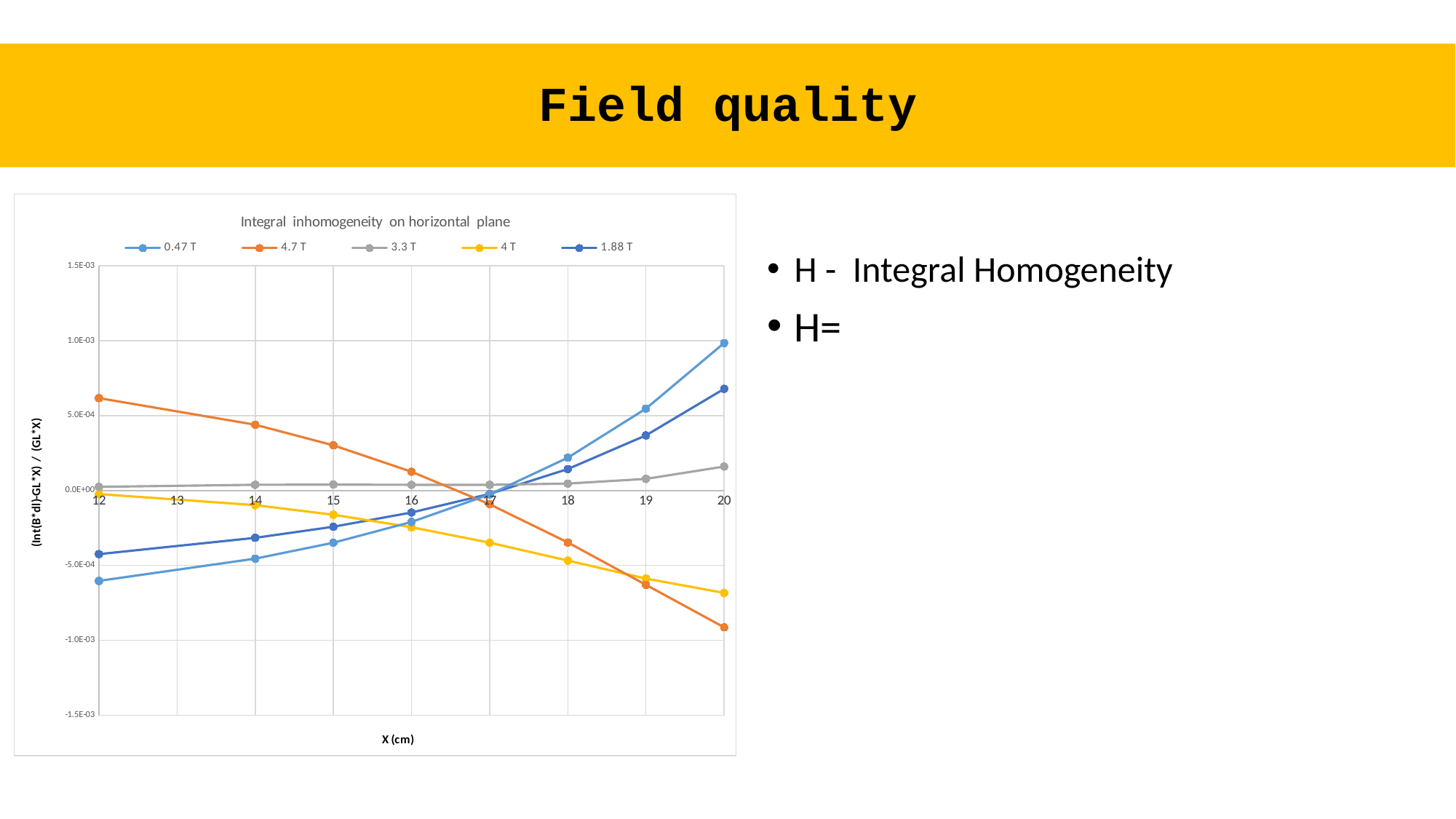
What kind of chart is shown on the slide? line chart At X = 20, which is larger: the 0.47 T series or the 1.88 T series? 0.47 T Is the value of the 4.7 T series at X = 12 greater or less than 5.0E-04? greater Does the 4.7 T series rise or fall as X increases from 12 to 20? fall How many series does the legend list? 5 What is the label of the x axis? X (cm) What is the title of the chart? Integral inhomogeneity on horizontal plane Which series has the highest value at X = 12? 4.7 T Which series has the highest value at X = 20? 0.47 T Which series has the lowest value at X = 20? 4.7 T Does the 0.47 T series rise or fall as X increases from 12 to 20? rise How many X (cm) points are plotted for each series? 8